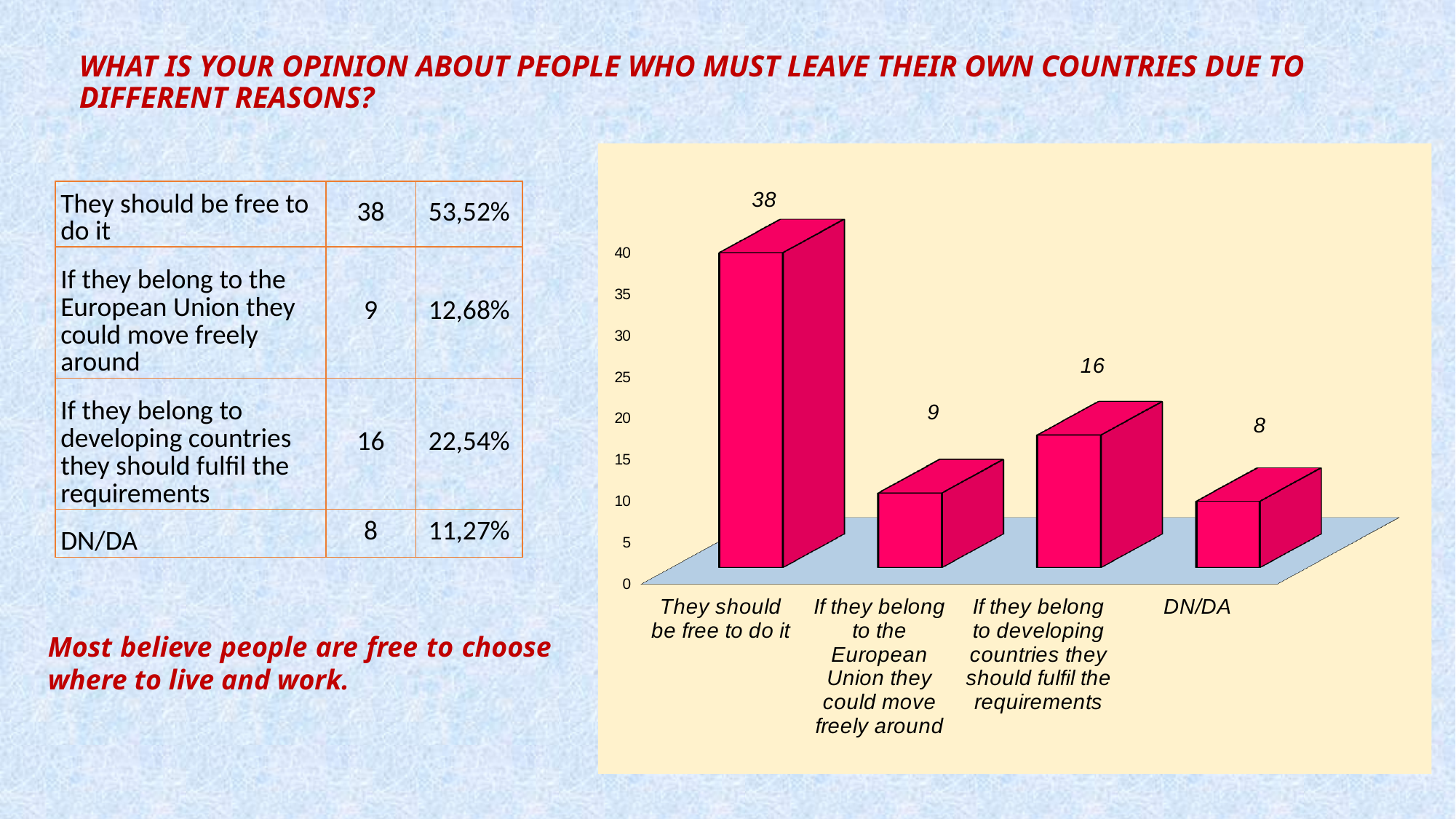
Which category has the lowest value? DN/DA Which is larger: the value for "If they belong to the European Union they could move freely around" or the value for "DN/DA"? If they belong to the European Union they could move freely around What kind of chart is shown on the slide? bar chart What is the difference between the values for "They should be free to do it" and "If they belong to developing countries they should fulfil the requirements"? 22 How many categories are shown in the chart? 4 What is the value for "DN/DA"? 8 What is the value for "They should be free to do it"? 38 Is the value for "If they belong to developing countries they should fulfil the requirements" greater or less than 20? less What is the value for "If they belong to developing countries they should fulfil the requirements"? 16 What is the highest value shown on the vertical axis of the chart? 40 Which category has the highest value? They should be free to do it What is the value for "If they belong to the European Union they could move freely around"? 9